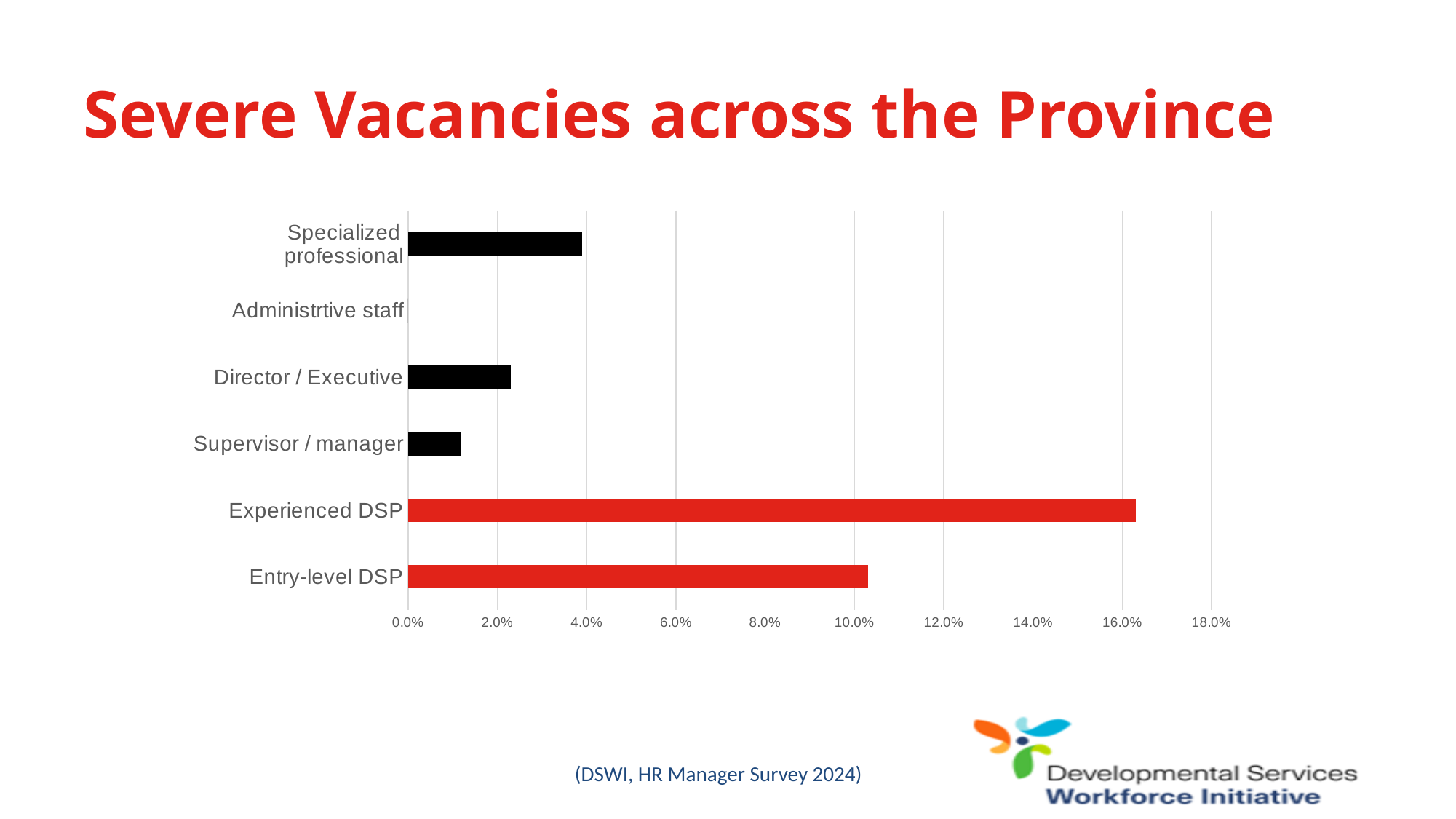
Is the value for Supervisor / manager greater or less than 2.0%? less Which has a higher vacancy rate, Specialized professional or Director / Executive? Specialized professional Which category has the lowest vacancy rate? Administrtive staff What is the title of the slide containing the chart? Severe Vacancies across the Province Is the value for Experienced DSP greater or less than 14.0%? greater Which has a higher vacancy rate, Director / Executive or Supervisor / manager? Director / Executive What type of chart is shown on the slide? bar chart Which two categories are drawn with red bars? Experienced DSP and Entry-level DSP How many job categories are shown on the chart? 6 Which has a higher vacancy rate, Experienced DSP or Entry-level DSP? Experienced DSP Which category has the highest vacancy rate? Experienced DSP Is the value for Entry-level DSP greater or less than 8.0%? greater